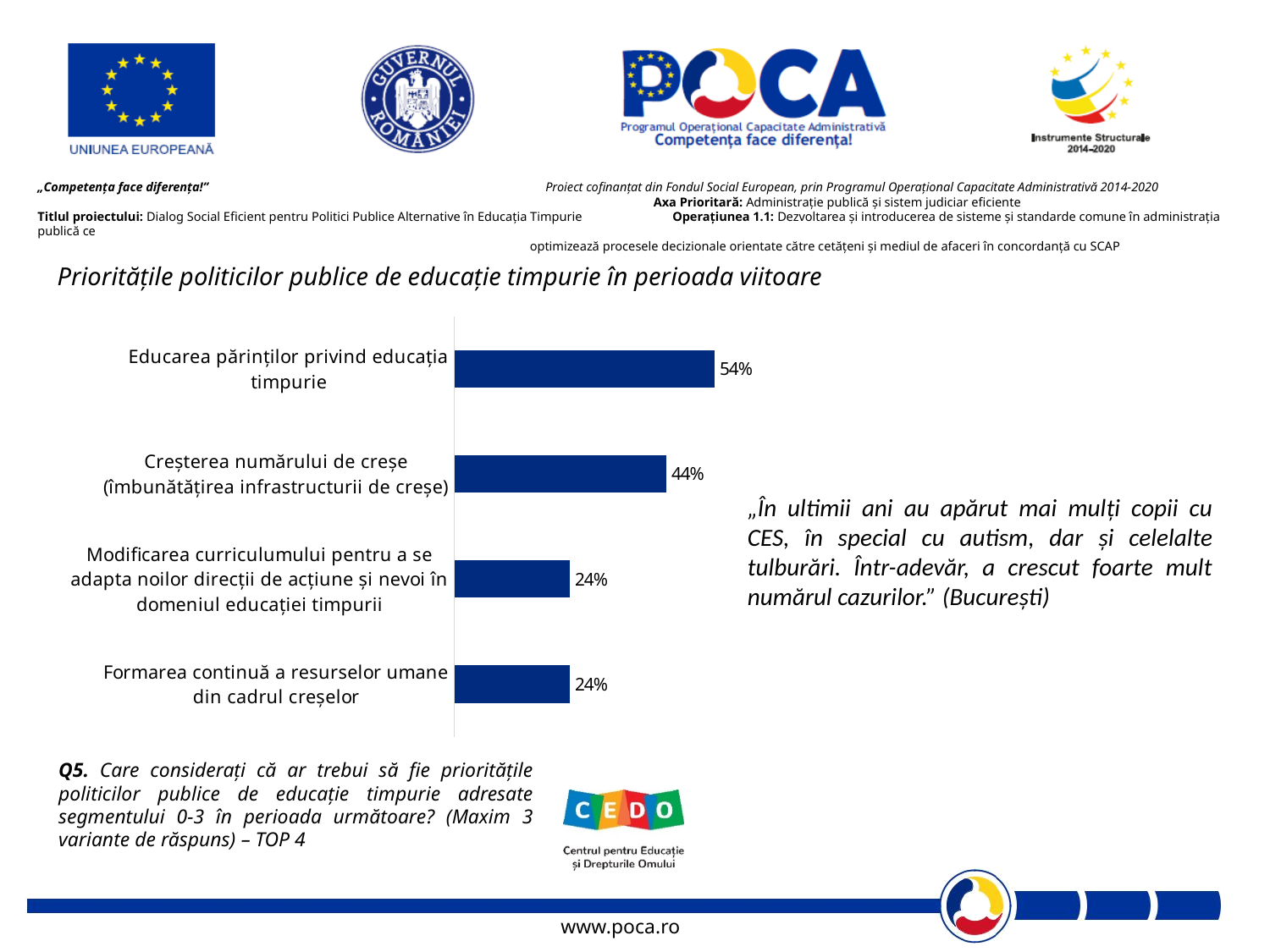
Which is larger: the value for "Creșterea numărului de creșe" or the value for "Formarea continuă a resurselor umane din cadrul creșelor"? Creșterea numărului de creșe How many categories are shown in the chart? 4 What is the difference between the values for "Educarea părinților privind educația timpurie" and "Creșterea numărului de creșe"? 10% What percentage is shown for "Formarea continuă a resurselor umane din cadrul creșelor"? 24% Which two categories share the same value of 24%? Modificarea curriculumului and Formarea continuă a resurselor umane din cadrul creșelor What type of chart is shown on the slide? Bar chart Which category has the highest value in the chart? Educarea părinților privind educația timpurie What colour are the bars in the chart? Dark blue What value is shown for "Creșterea numărului de creșe (îmbunătățirea infrastructurii de creșe)"? 44% What is the difference between the values for "Creșterea numărului de creșe" and "Modificarea curriculumului"? 20% What is the title of the chart on the slide? Prioritățile politicilor publice de educație timpurie în perioada viitoare What percentage is shown for "Educarea părinților privind educația timpurie"? 54%